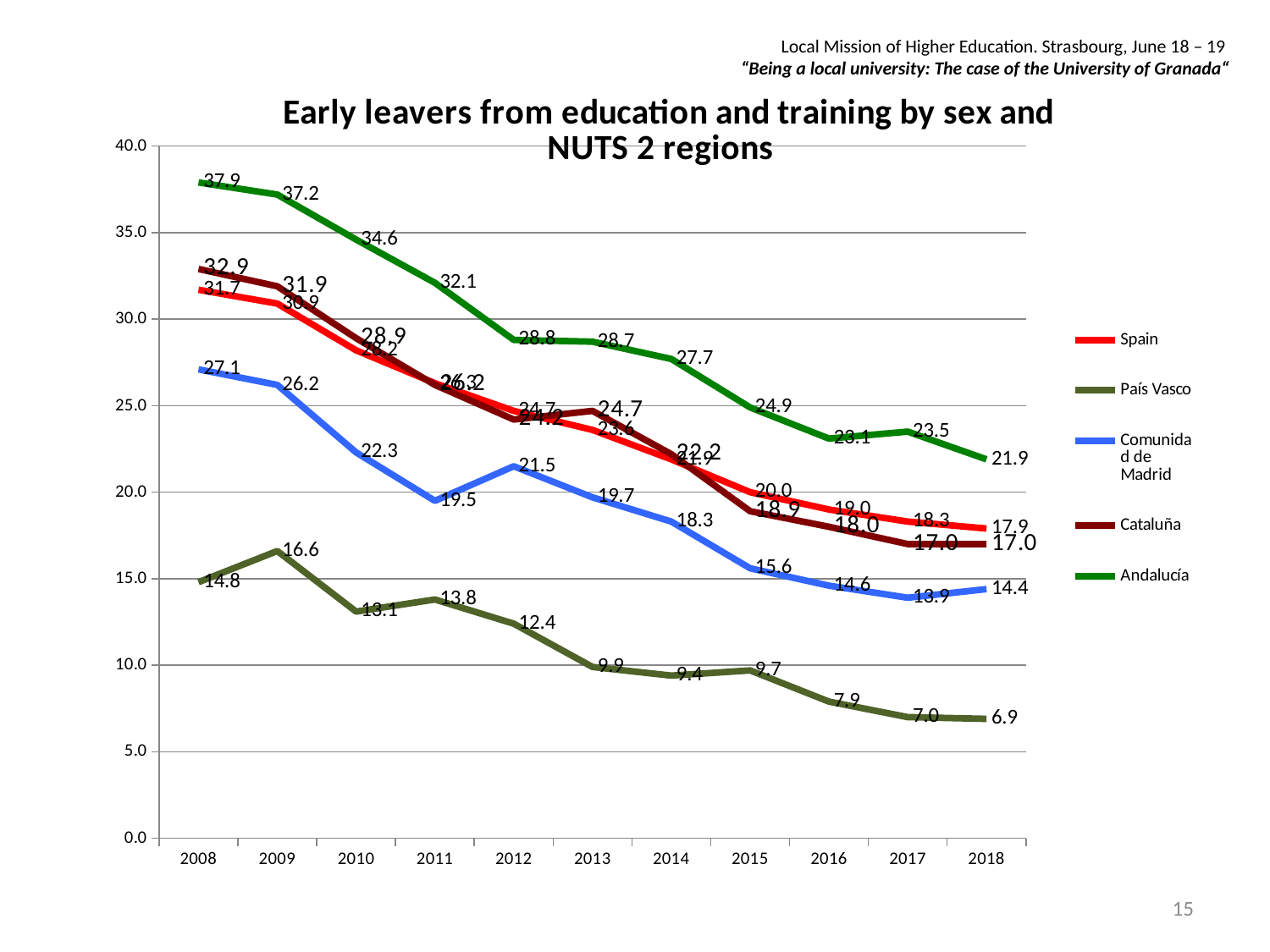
What is the difference between the Andalucía values in 2008 and 2018? 16.0 What is the title of the chart? Early leavers from education and training by sex and NUTS 2 regions What is the value for Andalucía in 2008? 37.9 What kind of chart is shown on the slide? line chart Does the Andalucía line rise or fall from 2008 to 2018? fall What is the value for Comunidad de Madrid in 2015? 15.6 Which series has the lowest value in 2018? País Vasco How many years are plotted along the x axis? 11 What is the value for País Vasco in 2018? 6.9 How many series does the legend list? 5 Which region has the highest value in 2018? Andalucía Which is larger for Comunidad de Madrid: the value in 2011 or the value in 2012? 2012